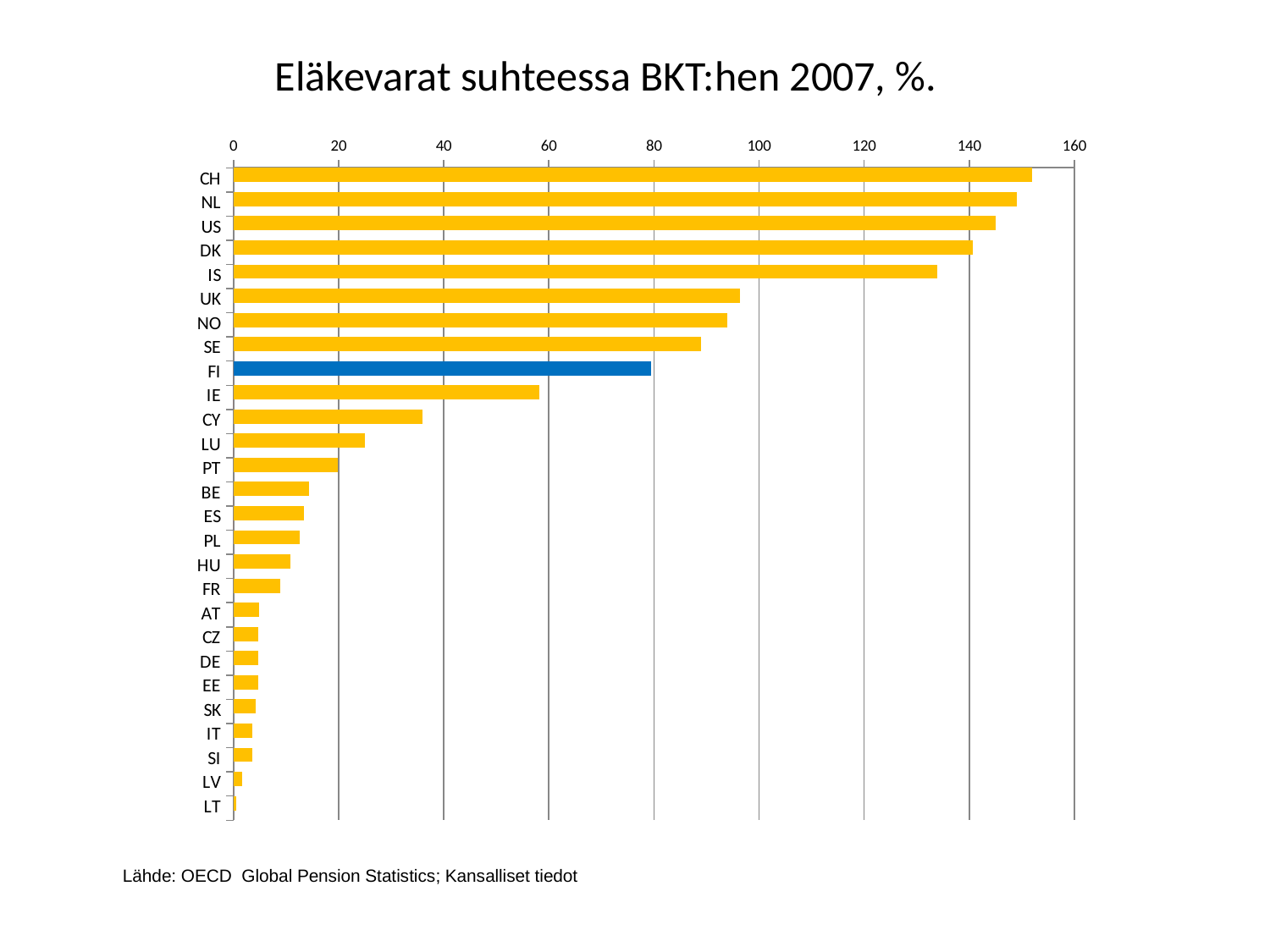
Which has the larger value, IS or UK? IS Is the value for IS greater or less than 140? less How many countries are shown in the chart? 27 Is the value for UK greater or less than 100? less Which has the larger value, FI or IE? FI What kind of chart is shown on the slide? bar chart Which country's bar is shown in a different colour (blue) from the others? FI Is the value for CH greater or less than 140? greater Which country has the lowest value in the chart? LT Which country has the highest pension assets relative to GDP in the chart? CH